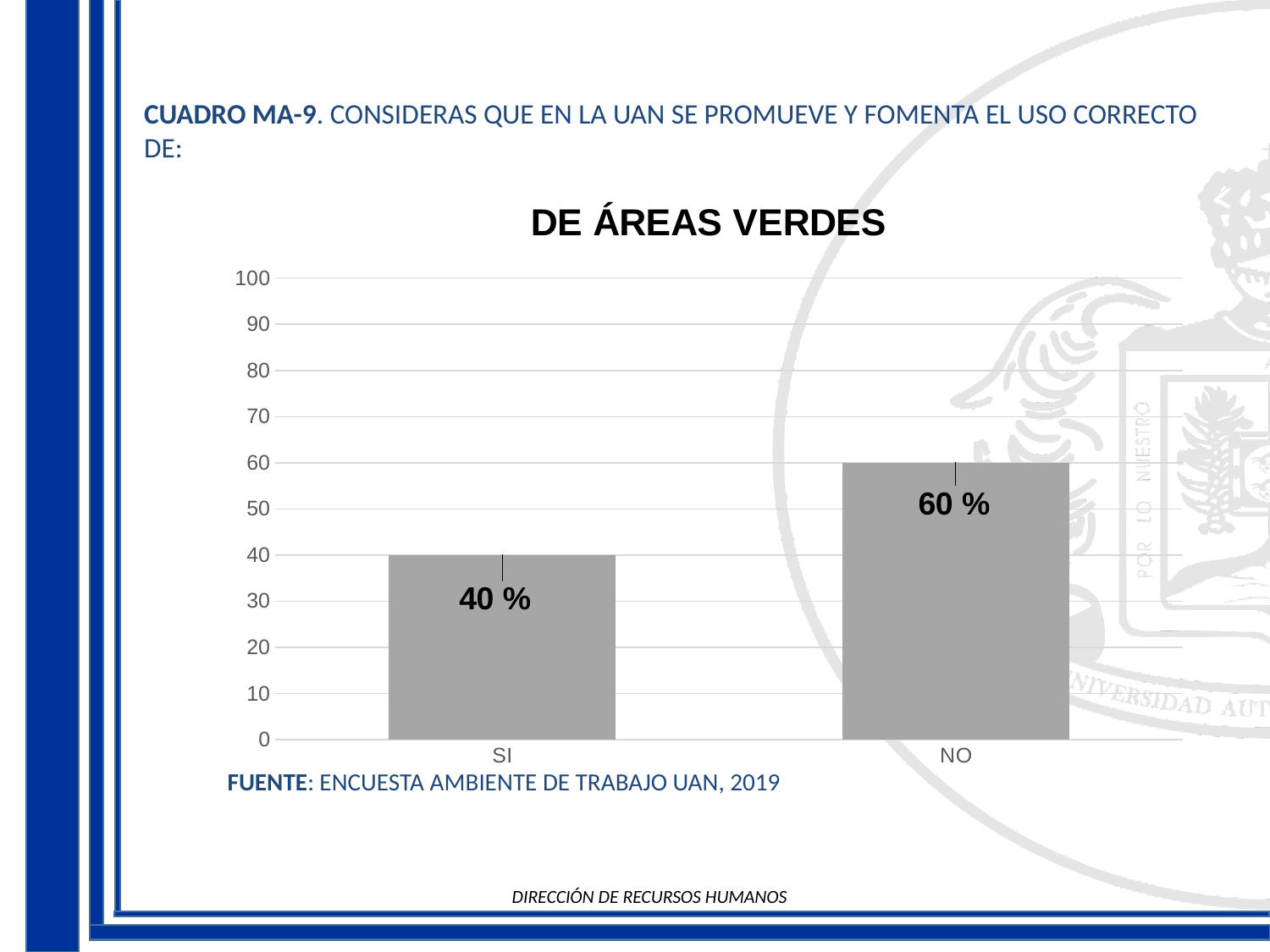
Which category has the highest value? NO What is the value for NO? 60 % Which is larger, the value for SI or the value for NO? NO What is the difference between the values for NO and SI? 20 % Is the value for SI greater or less than 50? less What kind of chart is shown on the slide? bar chart What is the maximum value shown on the y axis? 100 What is the title of the chart? DE ÁREAS VERDES Which category has the lowest value? SI How many categories are shown on the x axis? 2 Is the value for NO greater or less than 50? greater What is the value for SI? 40 %